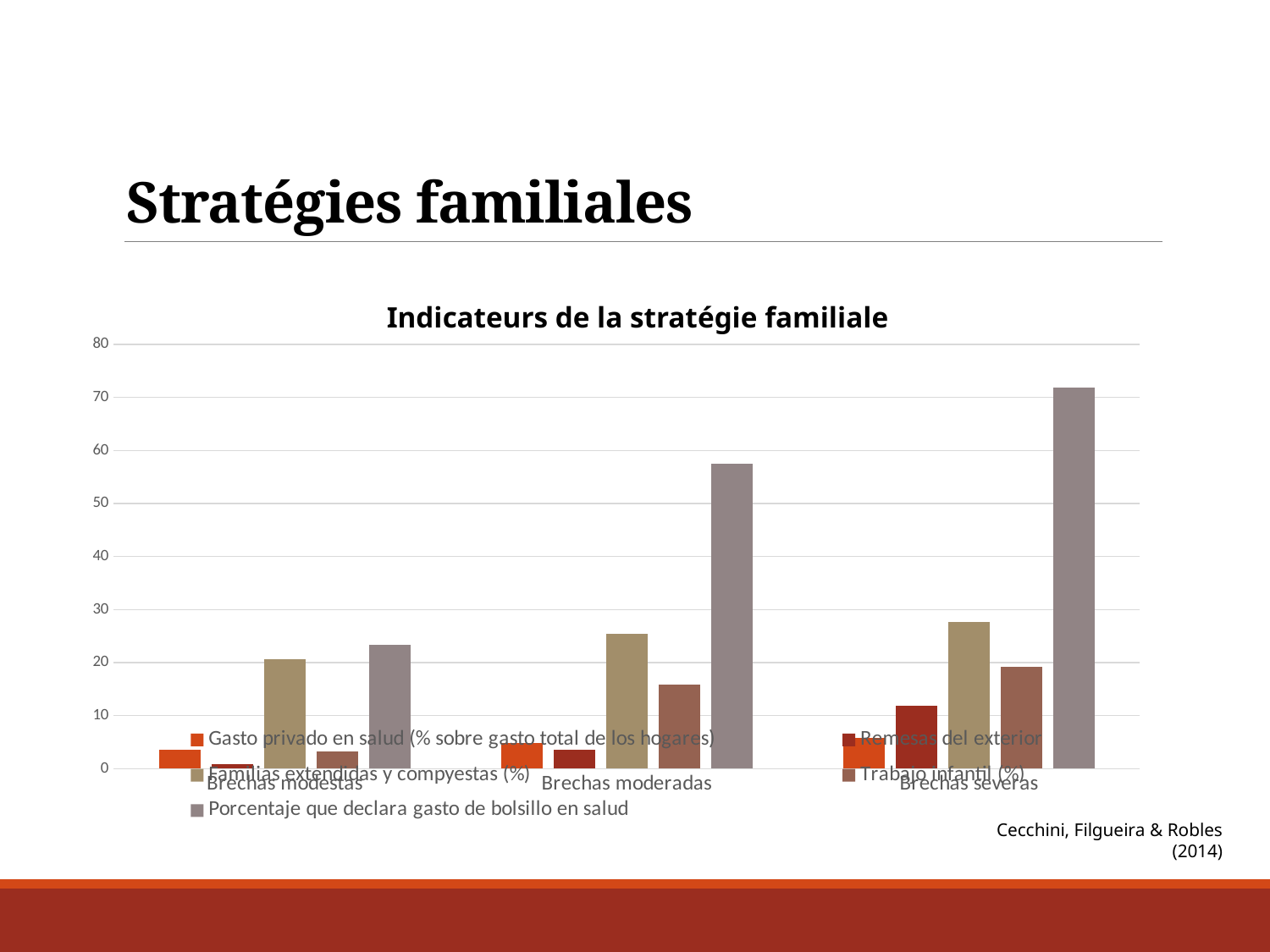
Is the value for 'Porcentaje que declara gasto de bolsillo en salud' in Brechas moderadas greater or less than 50? greater Which is larger in Brechas severas: 'Remesas del exterior' or 'Trabajo infantil (%)'? Trabajo infantil (%) How many series does the chart's legend list? 5 How many categories are shown on the x axis of the chart? 3 Which category has the lowest value for 'Porcentaje que declara gasto de bolsillo en salud'? Brechas modestas What kind of chart is shown on the slide? bar chart Which category has the highest value for 'Porcentaje que declara gasto de bolsillo en salud'? Brechas severas Is the value for 'Porcentaje que declara gasto de bolsillo en salud' in Brechas severas greater or less than 70? greater What is the title of the chart? Indicateurs de la stratégie familiale Which category has the highest value for 'Remesas del exterior'? Brechas severas Does the value for 'Porcentaje que declara gasto de bolsillo en salud' rise or fall from Brechas modestas to Brechas severas? rise Is the value for 'Familias extendidas y compuestas (%)' in Brechas modestas greater or less than 30? less